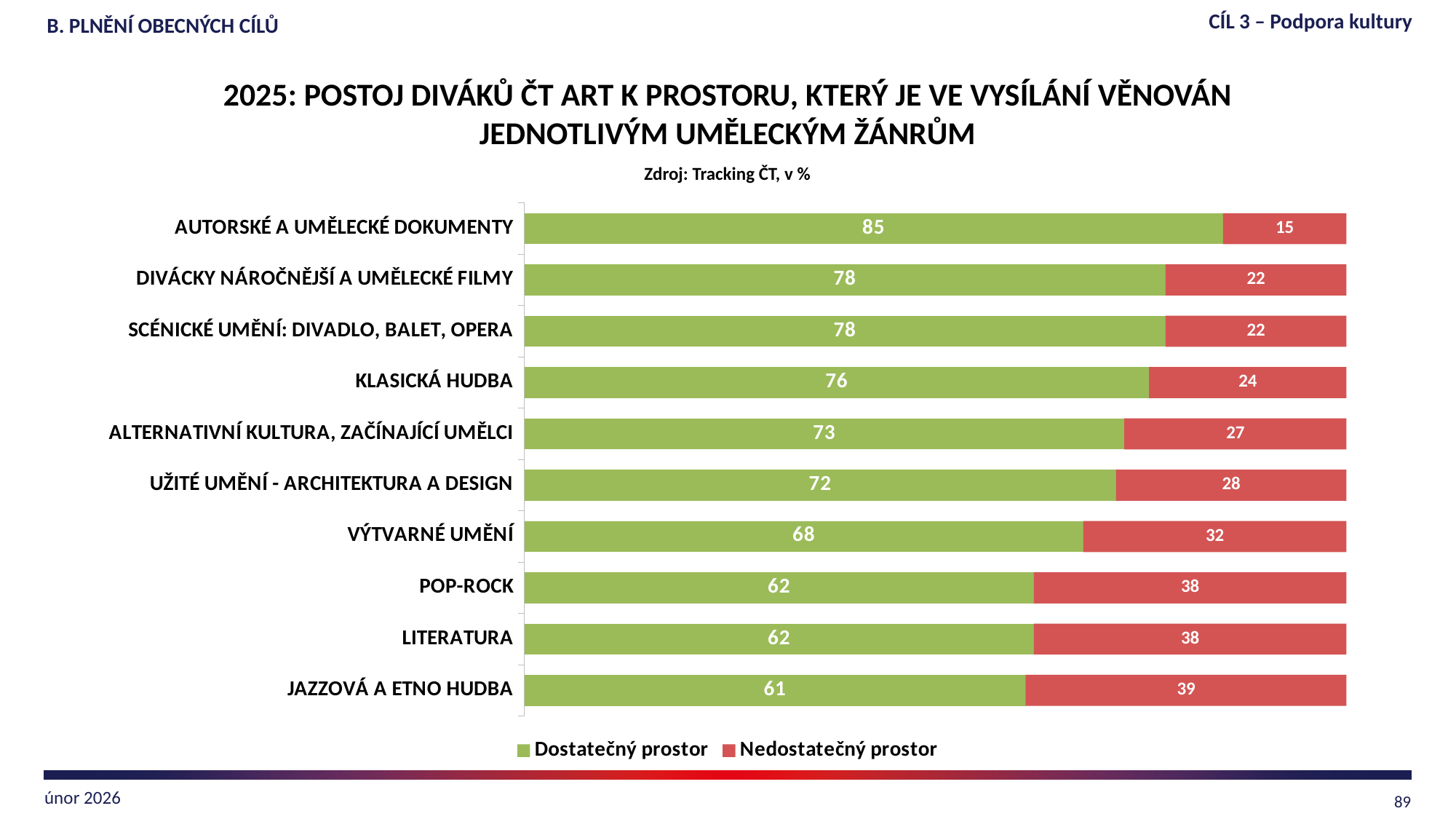
What is the 'Dostatečný prostor' value for JAZZOVÁ A ETNO HUDBA? 61 What is the total of the stacked bar for LITERATURA? 100 How many categories are shown in the chart? 10 What is the 'Nedostatečný prostor' value for VÝTVARNÉ UMĚNÍ? 32 What is the 'Dostatečný prostor' value for KLASICKÁ HUDBA? 76 Which is larger: the 'Nedostatečný prostor' value for KLASICKÁ HUDBA or for UŽITÉ UMĚNÍ - ARCHITEKTURA A DESIGN? UŽITÉ UMĚNÍ - ARCHITEKTURA A DESIGN Which category has the lowest 'Dostatečný prostor' value? JAZZOVÁ A ETNO HUDBA Which category has the highest 'Dostatečný prostor' value? AUTORSKÉ A UMĚLECKÉ DOKUMENTY Which category has the highest 'Nedostatečný prostor' value? JAZZOVÁ A ETNO HUDBA What is the difference between the 'Dostatečný prostor' values for AUTORSKÉ A UMĚLECKÉ DOKUMENTY and POP-ROCK? 23 How many series does the legend list? 2 What kind of chart is shown on the slide? Stacked bar chart